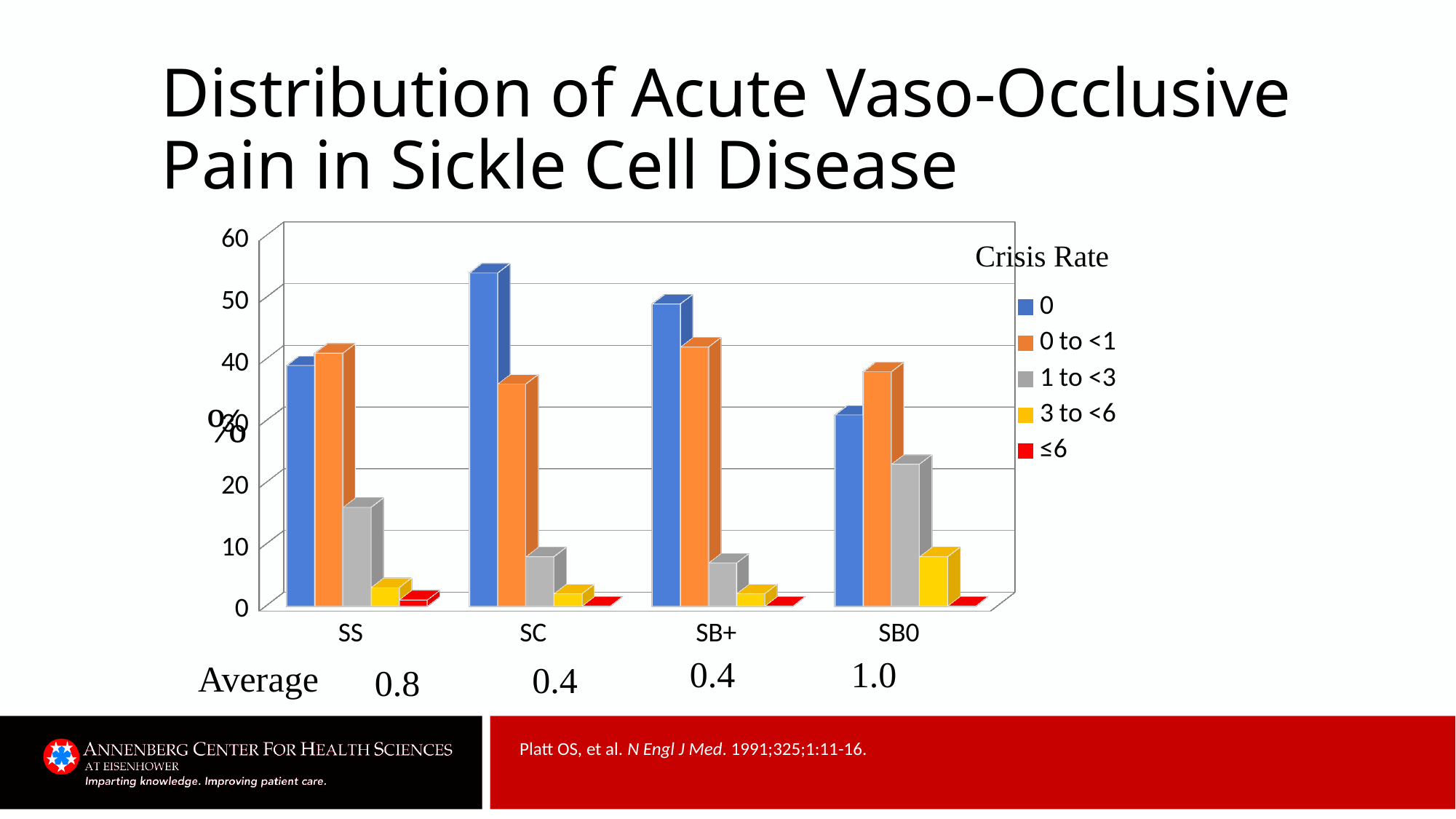
Which category has the tallest bar for the crisis rate '0' series? SC Which category has the shortest bar for the crisis rate '0' series? SB0 What kind of chart is shown on the slide? bar chart How many series does the chart's legend list? 5 Which category has the tallest bar for the '3 to <6' series? SB0 Is the value for the '0' series in the SC category greater or less than 50? greater What average value is printed below the SB0 category? 1.0 Is the value for the '1 to <3' series in the SS category greater or less than 20? less How many categories are shown on the x axis of the chart? 4 What is the title of the chart's legend? Crisis Rate Is the value for the '1 to <3' series in the SB0 category greater or less than 20? greater In the SB0 category, which is larger: the '0' series or the '0 to <1' series? 0 to <1